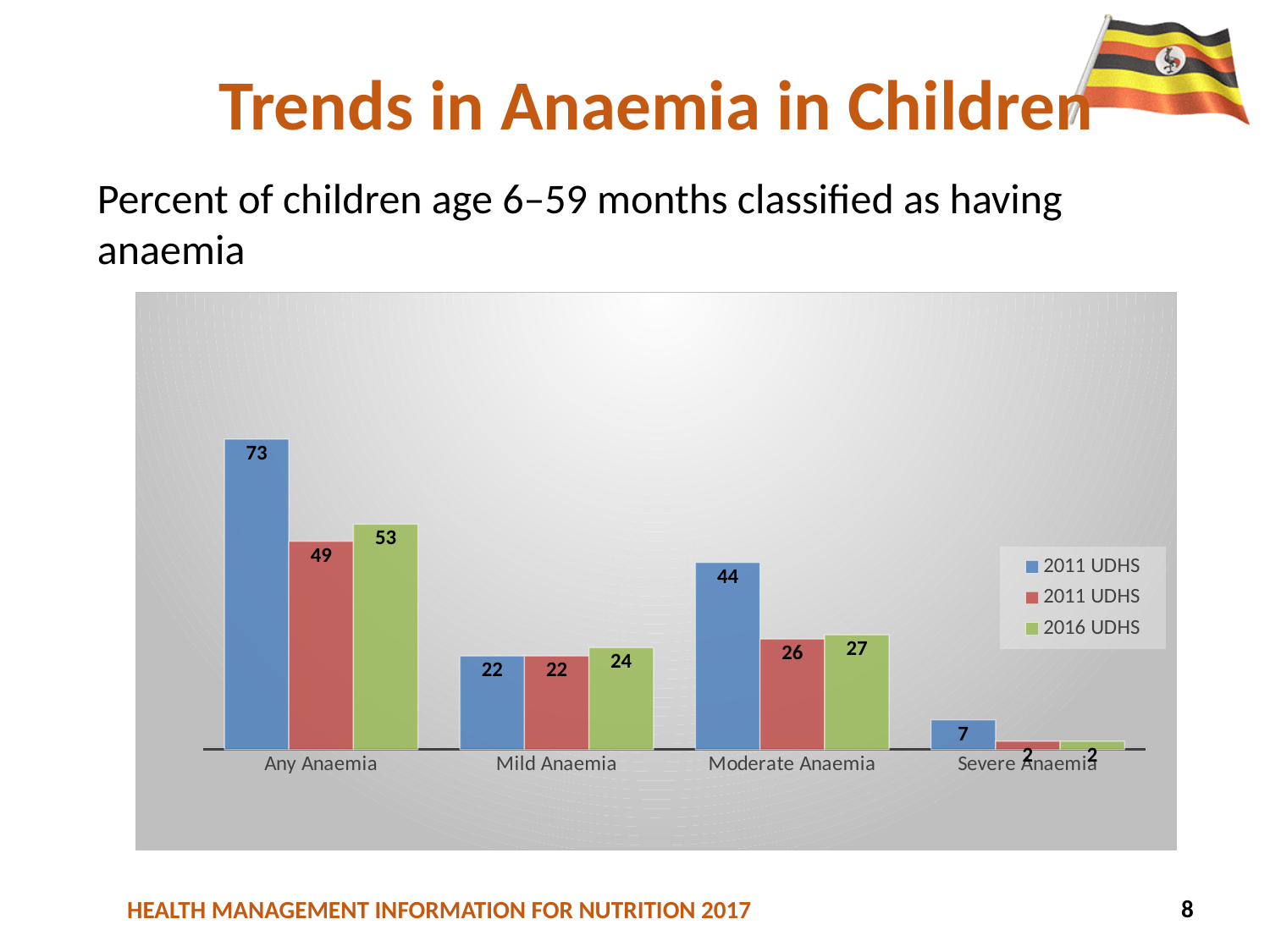
How many series does the legend list? 3 What is the difference between the blue bar and the red bar for Any Anaemia? 24 Which category has the highest blue bar? Any Anaemia What is the value of the blue bar for Any Anaemia? 73 For Moderate Anaemia, which is larger: the blue bar or the green bar? The blue bar (44) How many anaemia categories are shown on the x axis? 4 Which category has the lowest 2016 UDHS (green) bar? Severe Anaemia What is the value of the 2016 UDHS (green) bar for Mild Anaemia? 24 What is the value of the red bar for Severe Anaemia? 2 What is the value of the 2016 UDHS (green) bar for Moderate Anaemia? 27 What kind of chart is shown on the slide? Bar chart For the 2016 UDHS (green) series, what is the difference between Any Anaemia and Mild Anaemia? 29